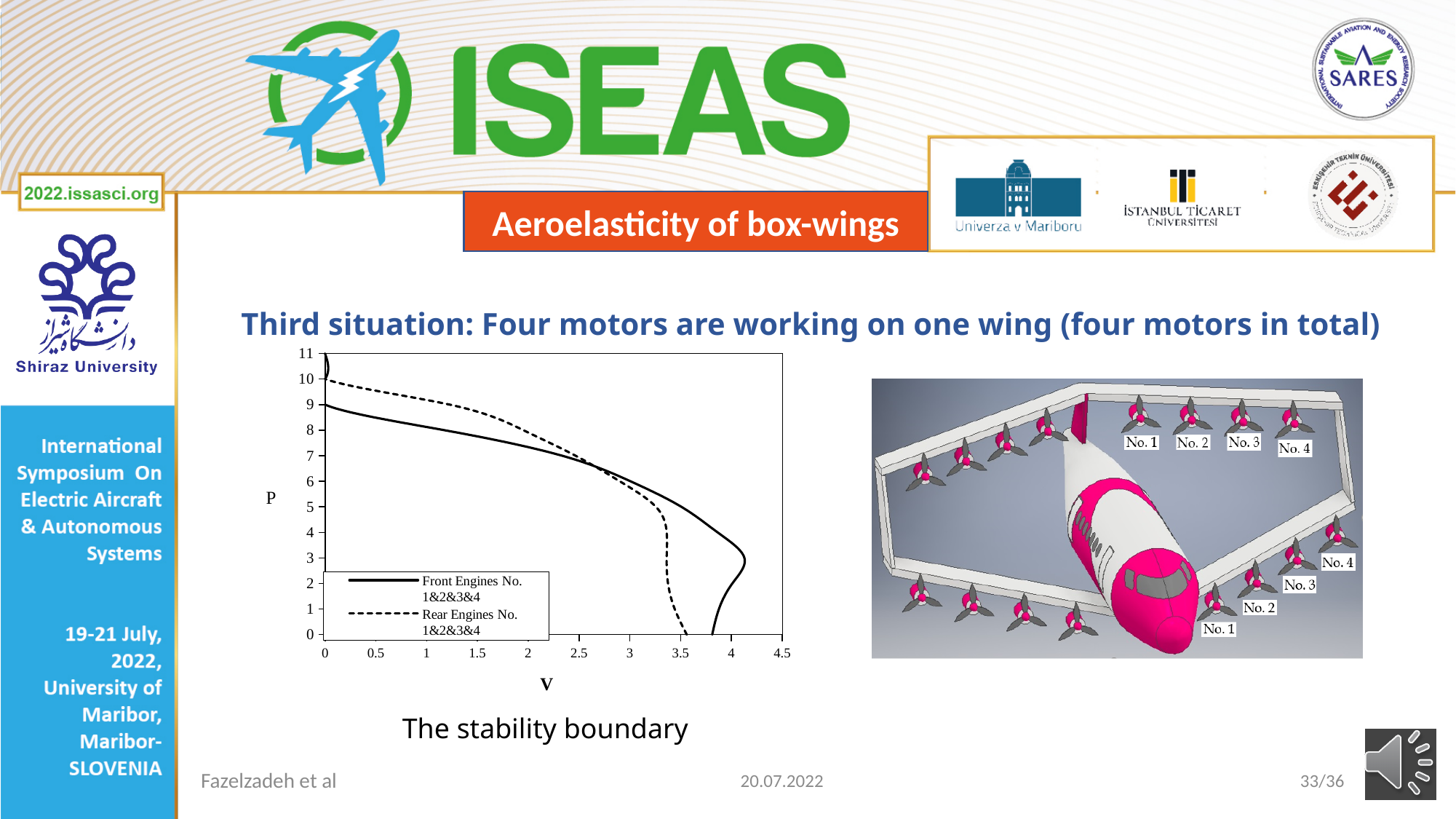
In the stability boundary chart, is the largest V value reached by the Front Engines No. 1&2&3&4 curve greater or less than 4? greater In the stability boundary chart, at P = 0, which curve has the larger V value: Front Engines No. 1&2&3&4 or Rear Engines No. 1&2&3&4? Front Engines No. 1&2&3&4 What is the highest tick value shown on the horizontal (V) axis of the stability boundary chart? 4.5 In the stability boundary chart, is the P value of the Rear Engines No. 1&2&3&4 curve at V = 0 greater or less than 9? greater What is the label of the vertical axis of the stability boundary chart? P In the stability boundary chart, is the largest V value reached by the Rear Engines No. 1&2&3&4 curve greater or less than 4? less Which series in the stability boundary chart is drawn with a dashed line? Rear Engines No. 1&2&3&4 How many series does the legend of the stability boundary chart list? 2 What kind of chart is shown on the slide? line chart In the stability boundary chart, at P = 8, which curve has the larger V value: Front Engines No. 1&2&3&4 or Rear Engines No. 1&2&3&4? Rear Engines No. 1&2&3&4 In the stability boundary chart, does the P value of the Rear Engines No. 1&2&3&4 curve rise or fall as V increases? fall